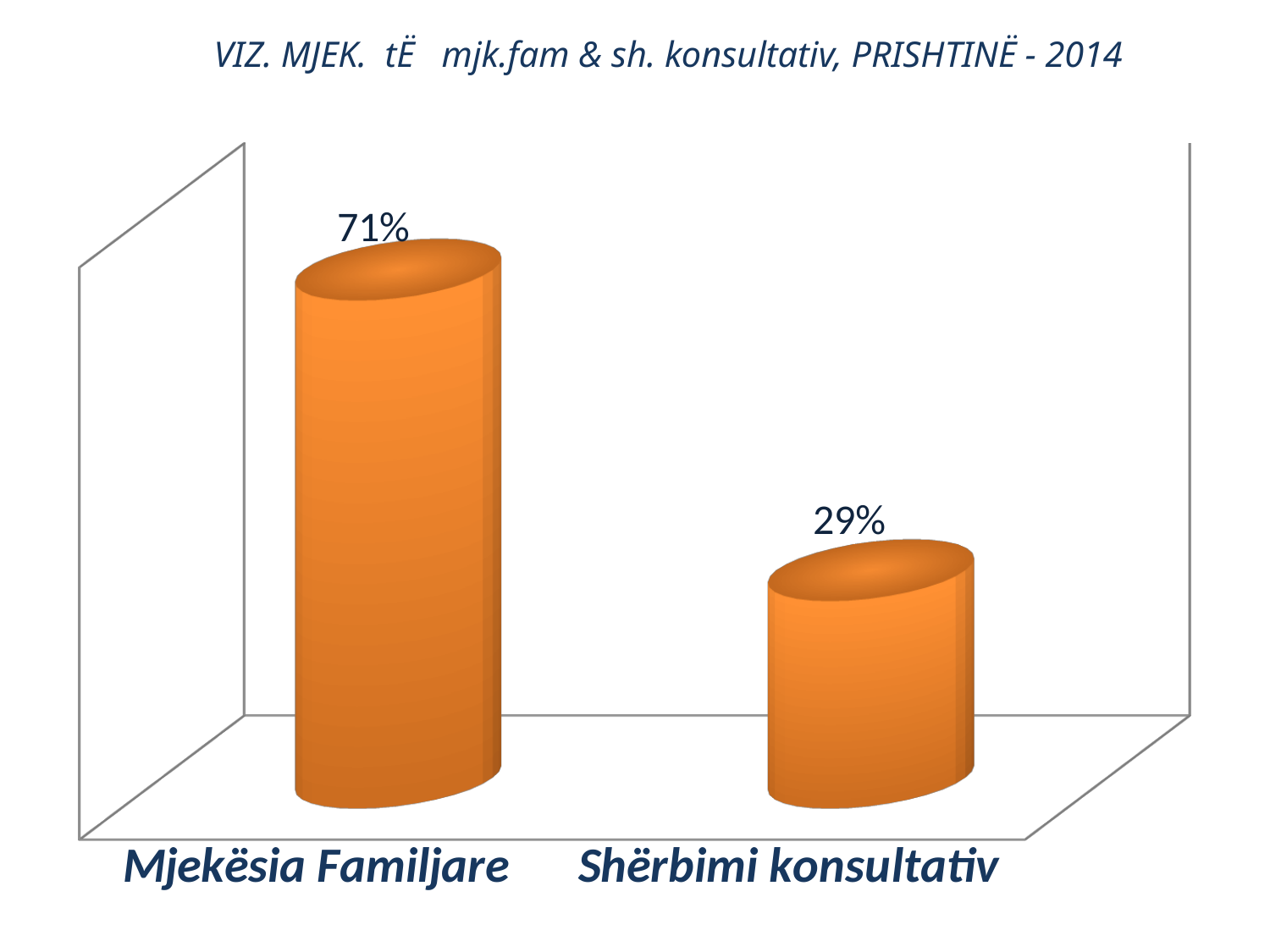
Which category has the lowest value? Shërbimi konsultativ What is the title of the chart? VIZ. MJEK. tË mjk.fam & sh. konsultativ, PRISHTINË - 2014 What colour are the bars in the chart? Orange What kind of chart is shown on the slide? Bar chart Which category has the highest value? Mjekësia Familjare What is the value for Shërbimi konsultativ? 29% What is the difference between the values for Mjekësia Familjare and Shërbimi konsultativ? 42% What is the value for Mjekësia Familjare? 71% What is the total of the two values shown in the chart? 100% How many categories are shown in the chart? 2 Which is larger, the value for Mjekësia Familjare or the value for Shërbimi konsultativ? Mjekësia Familjare